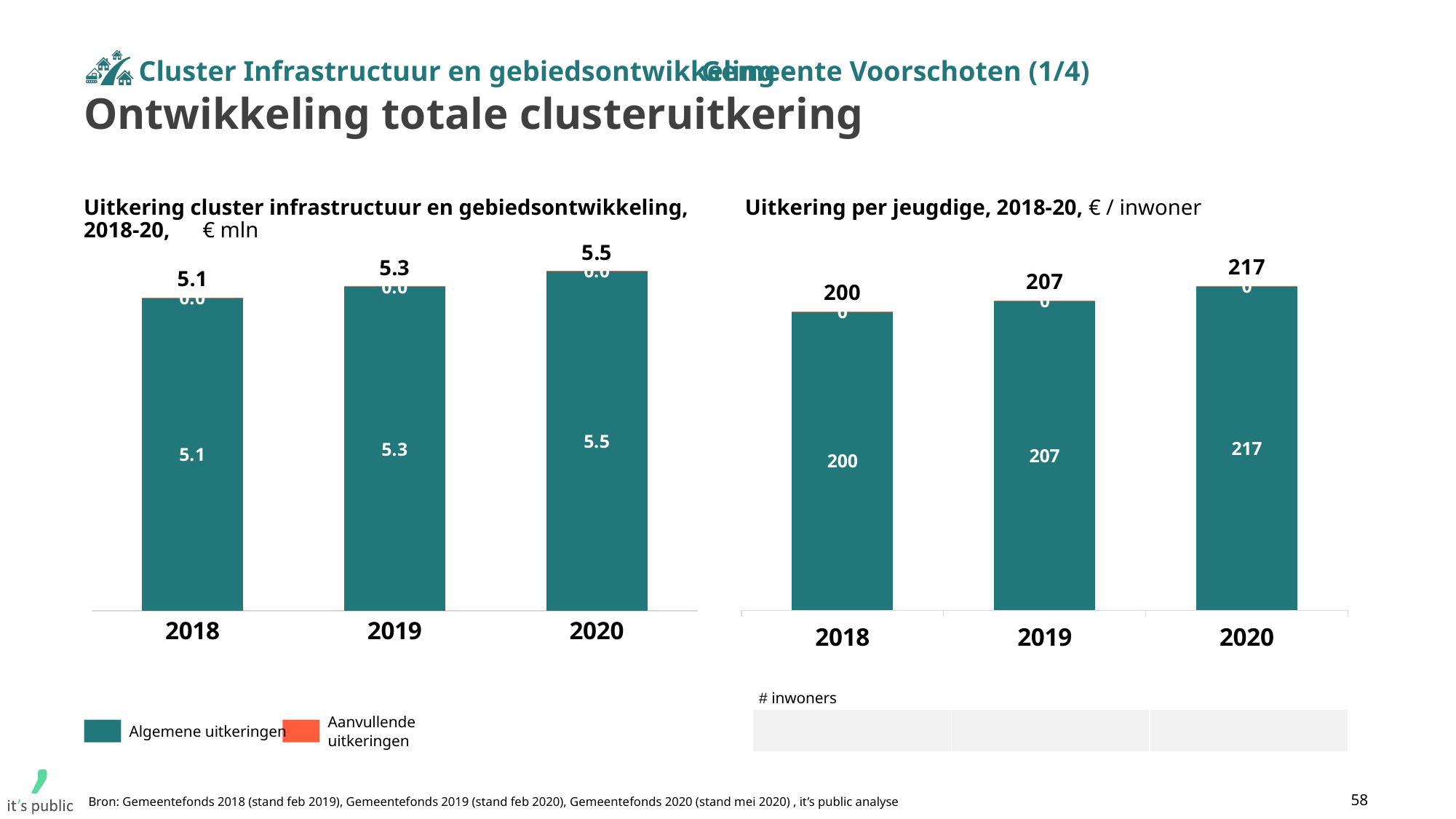
In the left chart (Uitkering cluster infrastructuur en gebiedsontwikkeling), what is the value of Algemene uitkeringen for 2019? 5.3 In the left chart (Uitkering cluster infrastructuur en gebiedsontwikkeling), what is the difference between the 2020 and 2018 totals? 0.4 In the left chart (Uitkering cluster infrastructuur en gebiedsontwikkeling), which year has the highest total? 2020 In the right chart (Uitkering per jeugdige), which year has the lowest value? 2018 In the left chart (Uitkering cluster infrastructuur en gebiedsontwikkeling), what is the total value for 2018? 5.1 What type of chart is the right chart (Uitkering per jeugdige)? bar chart In the left chart (Uitkering cluster infrastructuur en gebiedsontwikkeling), what is the total value for 2020? 5.5 In the right chart (Uitkering per jeugdige), what is the value for 2019? 207 In the left chart (Uitkering cluster infrastructuur en gebiedsontwikkeling), do the totals rise or fall from 2018 to 2020? rise In the right chart (Uitkering per jeugdige), what is the difference between the 2020 and 2018 values? 17 In the right chart (Uitkering per jeugdige), how many years are shown on the x axis? 3 In the left chart (Uitkering cluster infrastructuur en gebiedsontwikkeling), how many series does the legend list? 2